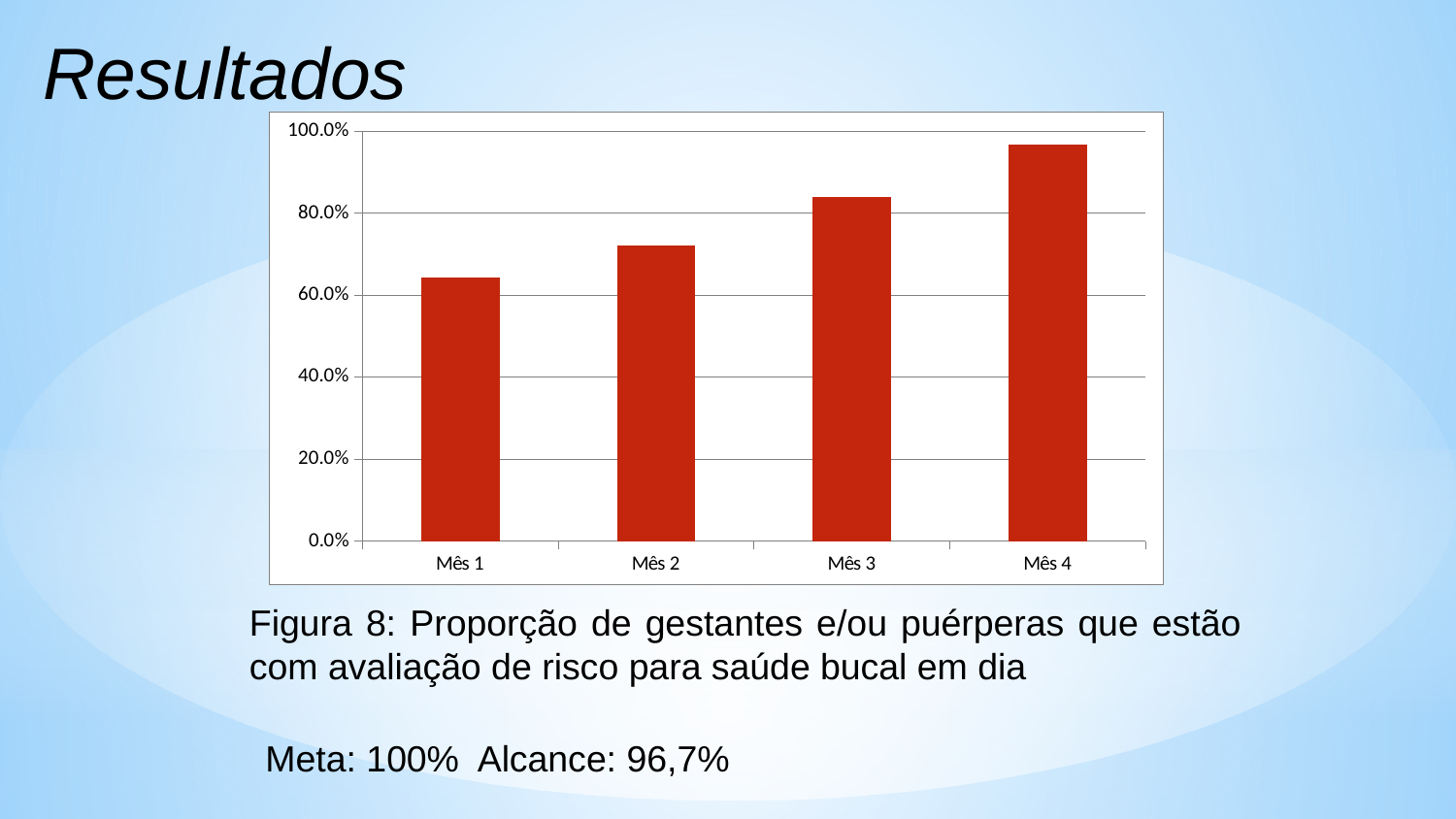
Is the value for Mês 2 greater or less than 80.0%? less What colour are the bars in the chart? red Which is larger, the value for Mês 3 or the value for Mês 2? Mês 3 Is the value for Mês 4 greater or less than 100.0%? less Is the value for Mês 1 greater or less than 60.0%? greater What is the figure number given in the caption below the chart? Figura 8 Do the values rise or fall from Mês 1 to Mês 4? rise Which month has the highest bar in the chart? Mês 4 How many categories (months) are shown on the x axis of the chart? 4 Which month has the lowest bar in the chart? Mês 1 What kind of chart is shown on the slide? bar chart